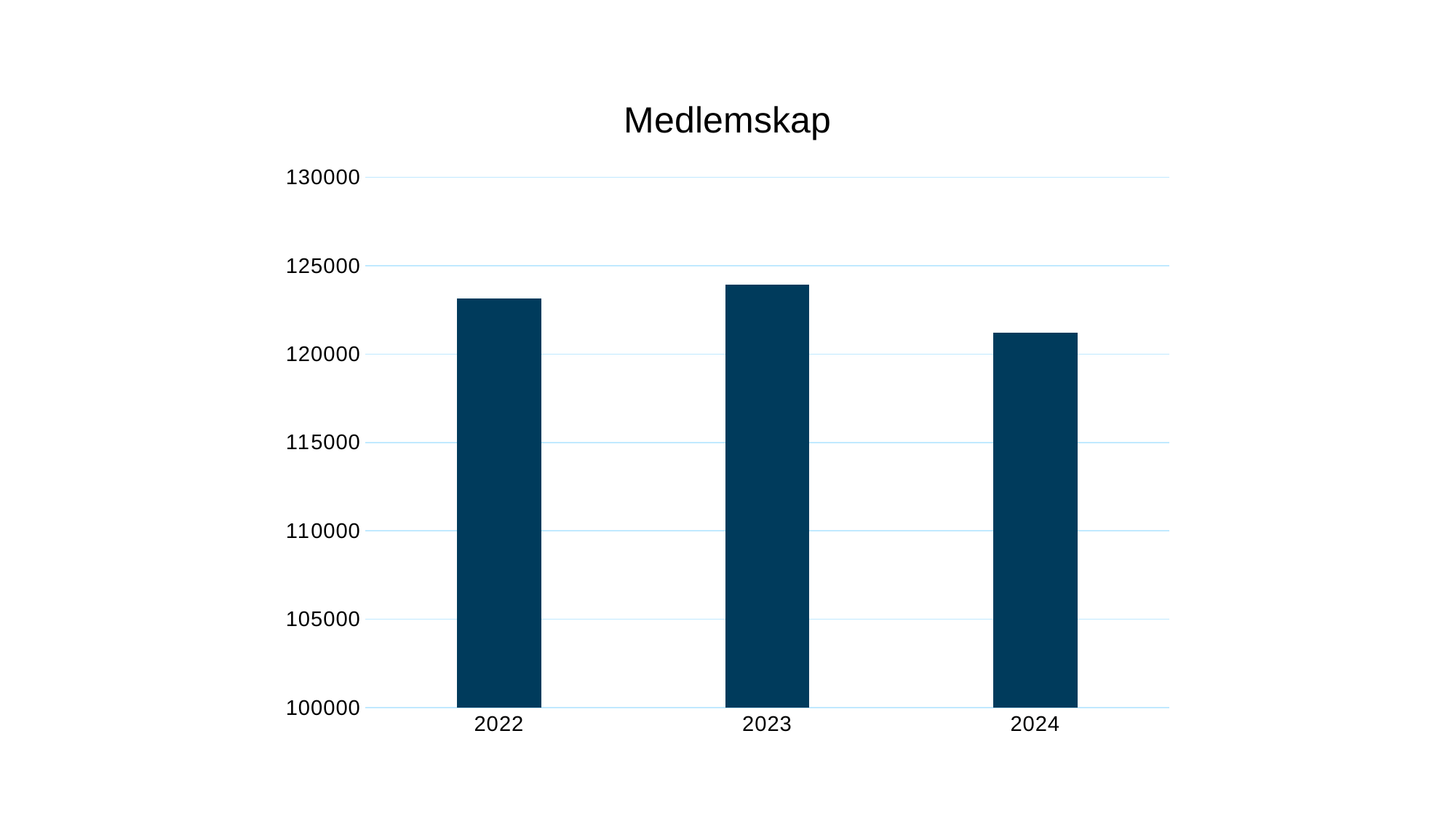
Which year has the highest value in the chart? 2023 Which is larger, the value for 2023 or the value for 2024? 2023 Which is larger, the value for 2022 or the value for 2024? 2022 What kind of chart is shown on the slide? bar chart Is the value for 2024 greater or less than 120000? greater What is the title of the chart? Medlemskap Does the value rise or fall from 2023 to 2024? fall Is the value for 2024 greater or less than 125000? less Is the value for 2023 greater or less than 125000? less Which year has the lowest value in the chart? 2024 How many years are shown on the x axis of the chart? 3